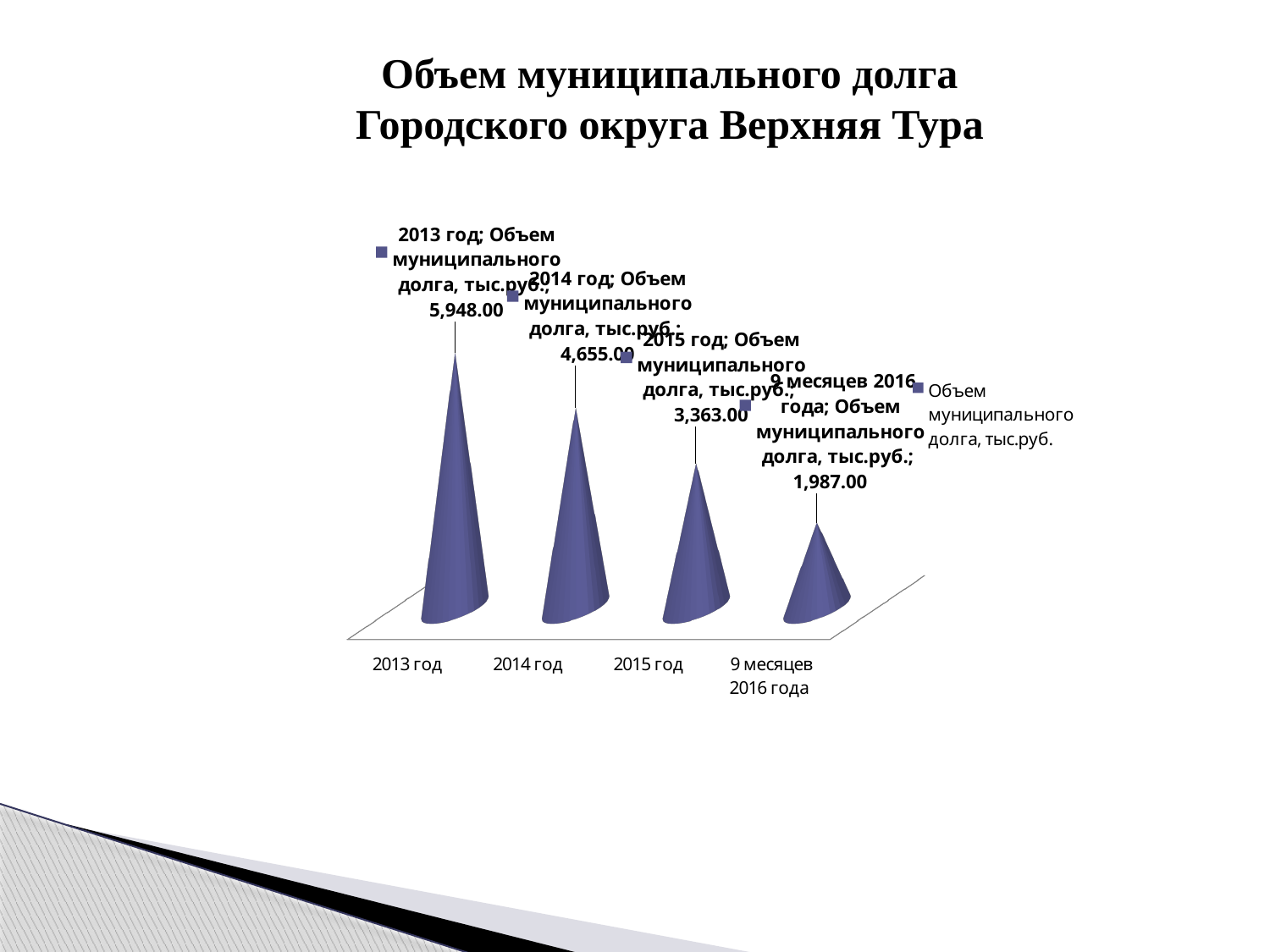
Which is larger, the value for 2014 год or the value for 2015 год? 2014 год What is the value for 2013 год? 5,948.00 Do the values rise or fall from 2013 год to 9 месяцев 2016 года? fall Which category has the lowest value? 9 месяцев 2016 года What is the value for 2014 год? 4,655.00 How many categories are shown on the x axis? 4 What is the value for 9 месяцев 2016 года? 1,987.00 What is the value for 2015 год? 3,363.00 What is the difference between the values for 2015 год and 9 месяцев 2016 года? 1,376.00 Which category has the highest value? 2013 год What is the difference between the values for 2013 год and 2014 год? 1,293.00 How many series does the legend list? 1